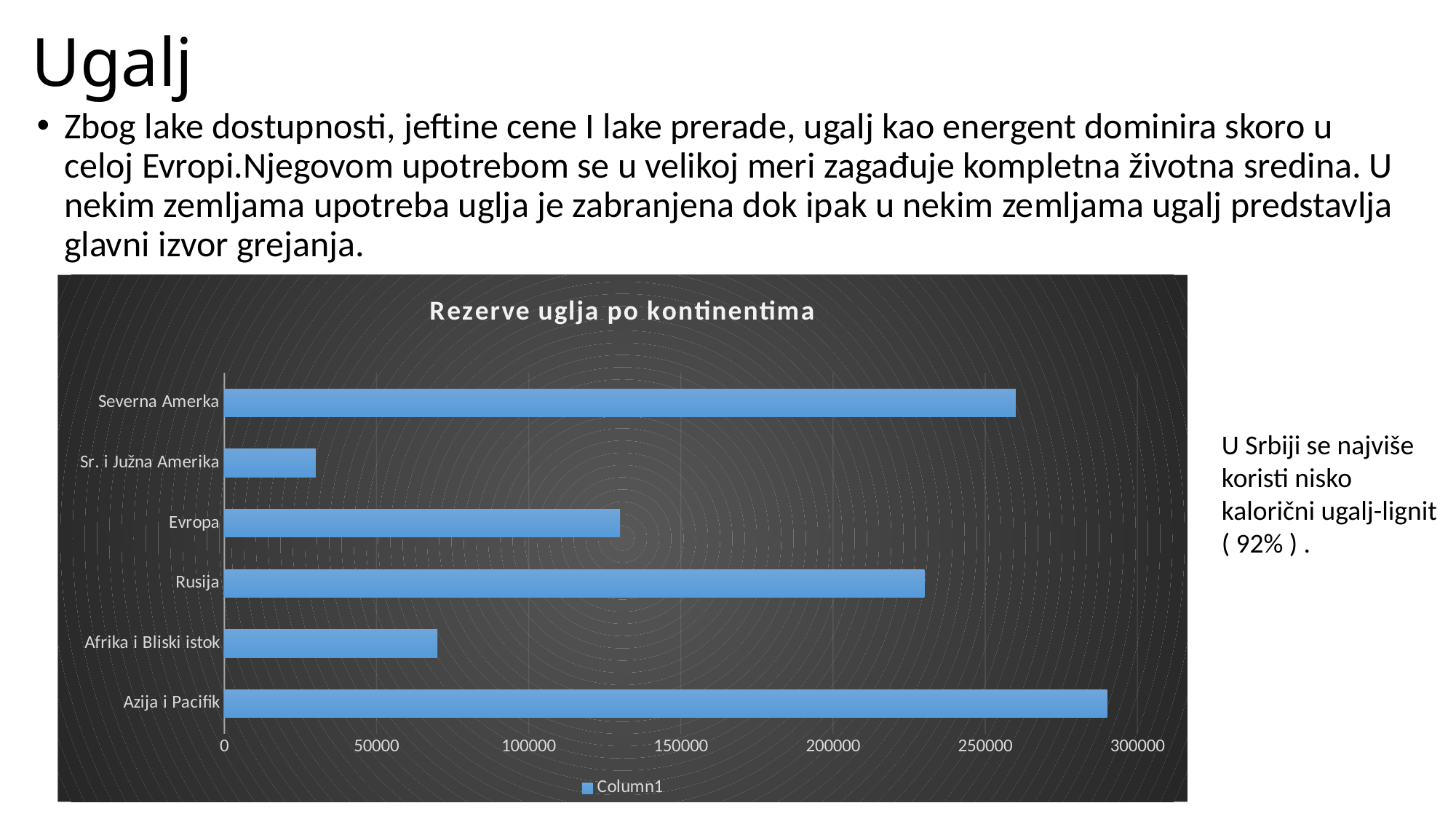
Is the value for Azija i Pacifik greater or less than 250000? greater Which is larger, the value for Evropa or the value for Afrika i Bliski istok? Evropa What is the name of the series shown in the legend? Column1 How many series does the legend list? 1 Which is larger, the value for Severna Amerka or the value for Rusija? Severna Amerka Which category has the highest value? Azija i Pacifik Is the value for Sr. i Južna Amerika greater or less than 50000? less What kind of chart is shown on the slide? bar chart Is the value for Rusija greater or less than 200000? greater How many categories are plotted in the chart? 6 Which category has the lowest value? Sr. i Južna Amerika What is the title of the chart? Rezerve uglja po kontinentima